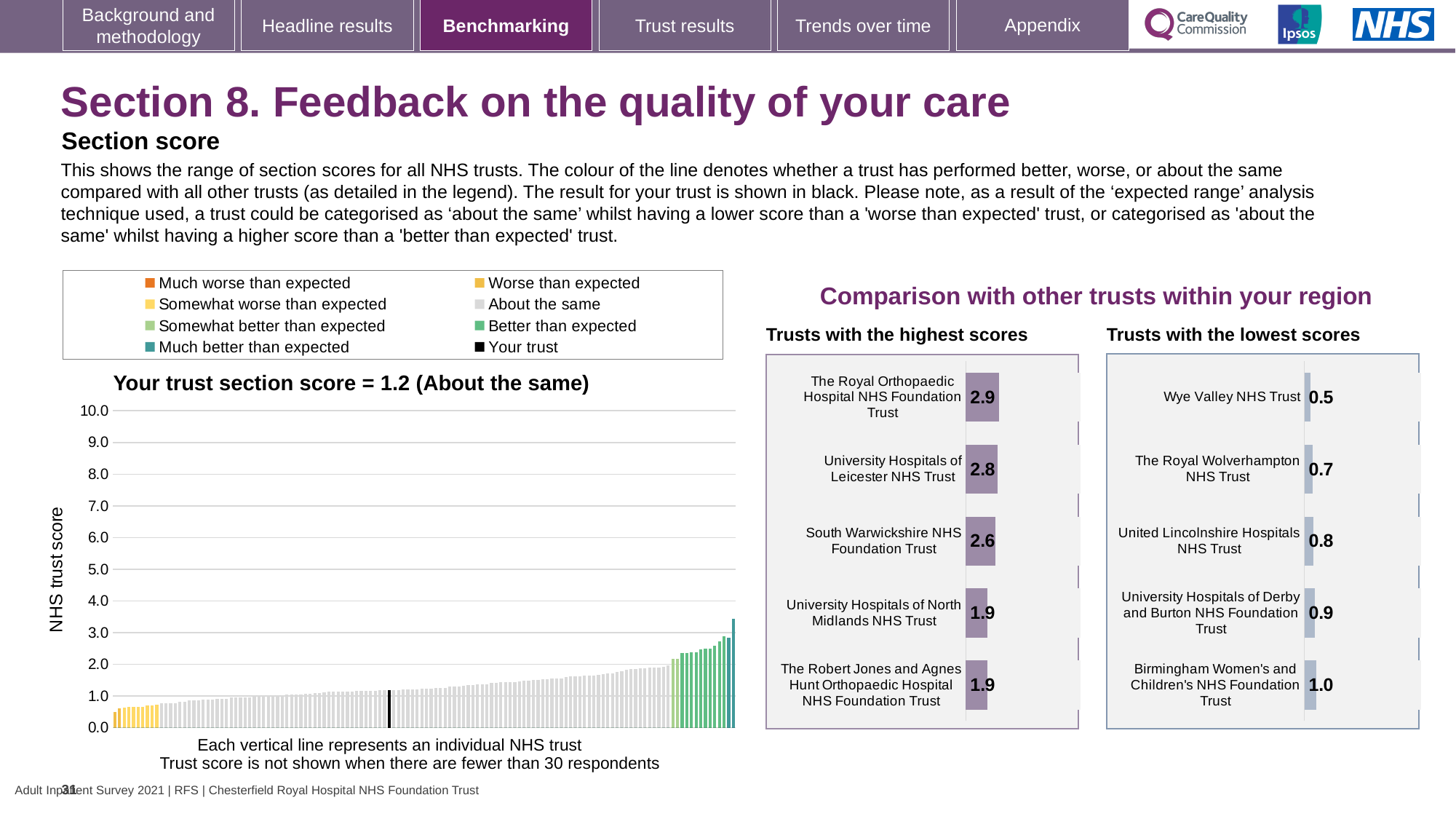
In the 'Trusts with the lowest scores' chart, what is the difference between the scores of Birmingham Women's and Children's NHS Foundation Trust and Wye Valley NHS Trust? 0.5 In the 'Trusts with the lowest scores' chart, what is the score for Wye Valley NHS Trust? 0.5 In the 'Trusts with the highest scores' chart, what is the score for The Royal Orthopaedic Hospital NHS Foundation Trust? 2.9 In the 'Trusts with the highest scores' chart, what is the score for South Warwickshire NHS Foundation Trust? 2.6 How many trusts are shown in the 'Trusts with the highest scores' chart? 5 In the 'Trusts with the highest scores' chart, which trust has the highest score? The Royal Orthopaedic Hospital NHS Foundation Trust In the 'Trusts with the lowest scores' chart, which trust has the lowest score? Wye Valley NHS Trust How many entries does the legend above the 'Your trust section score' chart list? 8 In the 'Trusts with the lowest scores' chart, which has the higher score: The Royal Wolverhampton NHS Trust or University Hospitals of Derby and Burton NHS Foundation Trust? University Hospitals of Derby and Burton NHS Foundation Trust In the 'Trusts with the highest scores' chart, what is the difference between the scores of The Royal Orthopaedic Hospital NHS Foundation Trust and South Warwickshire NHS Foundation Trust? 0.3 In the 'Your trust section score' chart, do the bar values rise or fall from left to right? rise In the 'Your trust section score' chart, is the value of the tallest bar greater or less than 3.0? greater